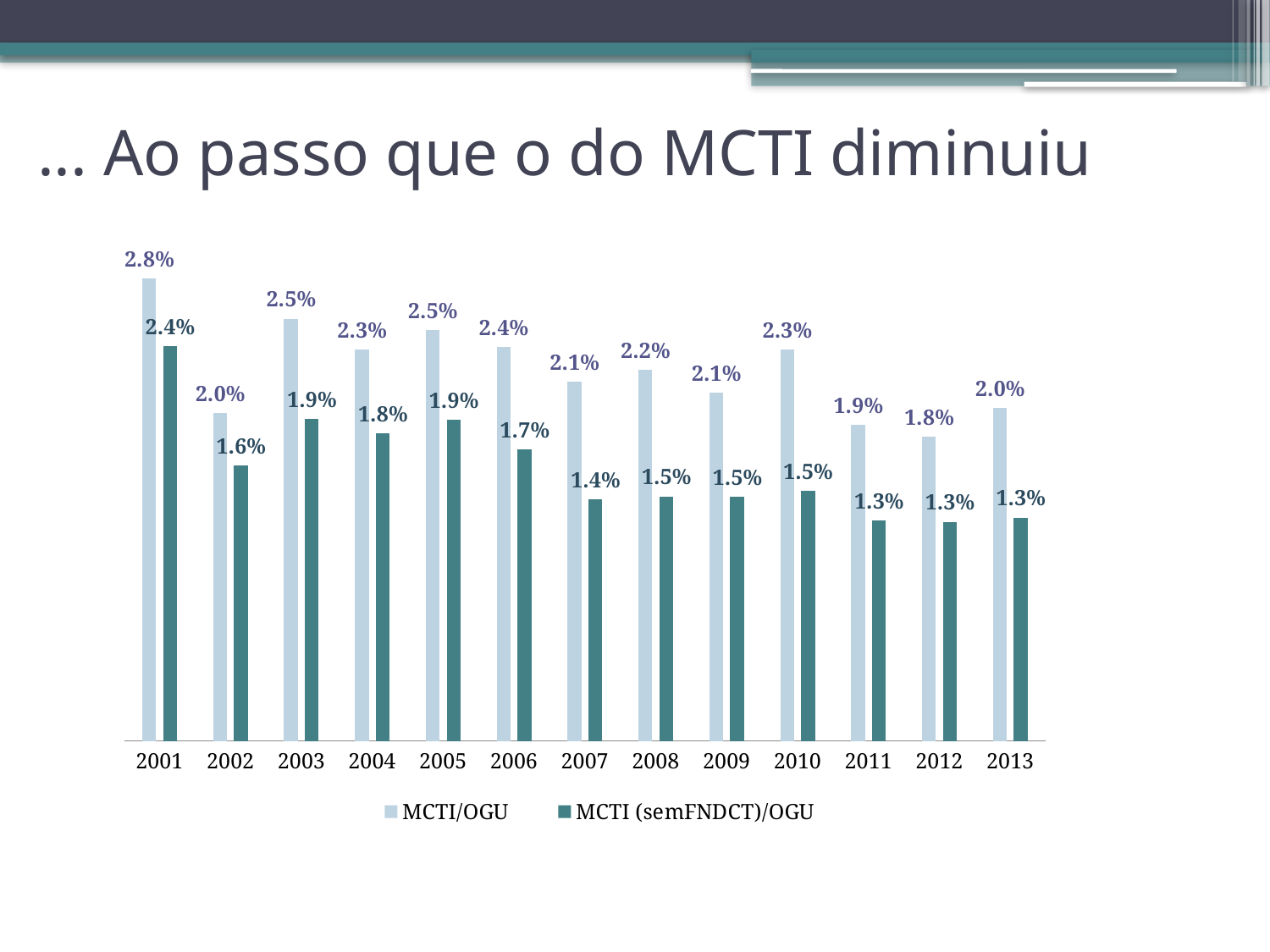
What is the value of MCTI (semFNDCT)/OGU for 2006? 1.7% How many series does the legend list? 2 In which year is MCTI (semFNDCT)/OGU highest? 2001 What is the value of MCTI/OGU for 2012? 1.8% What is the difference between MCTI/OGU in 2001 and MCTI/OGU in 2002? 0.8% What is the difference between MCTI/OGU and MCTI (semFNDCT)/OGU in 2013? 0.7% Which is larger: MCTI/OGU in 2003 or MCTI/OGU in 2007? 2003 In which year is MCTI/OGU lowest? 2012 What kind of chart is shown on the slide? Bar chart How many years are shown on the x axis? 13 In which year is MCTI/OGU highest? 2001 What is the value of MCTI/OGU for 2001? 2.8%